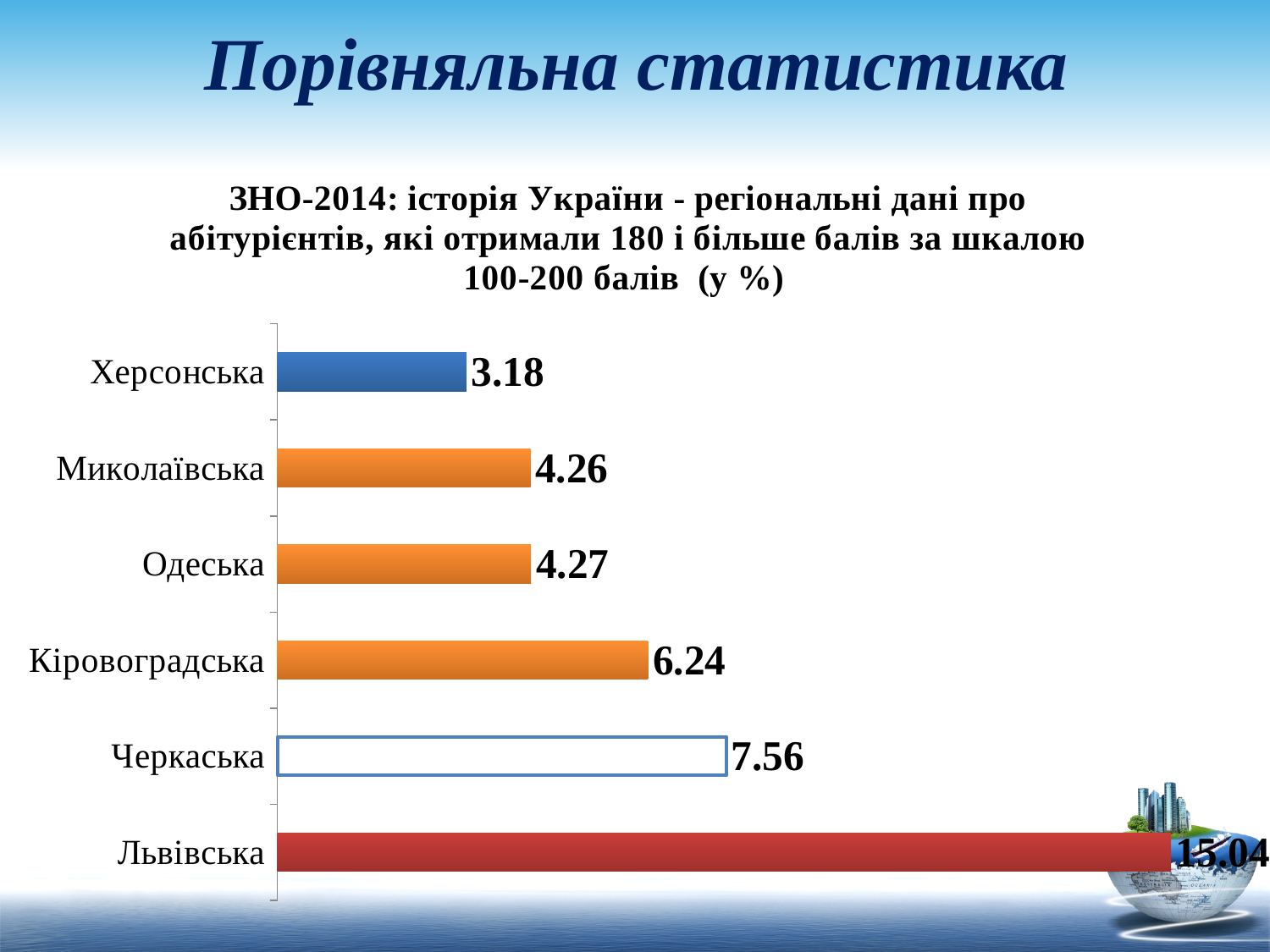
What is the difference between the values for Кіровоградська and Херсонська? 3.06 What colour is the bar for Львівська? Red How many regions are shown in the chart? 6 What is the value for Львівська? 15.04 Which region has the highest value? Львівська What is the difference between the values for Львівська and Черкаська? 7.48 Which is larger, the value for Черкаська or the value for Кіровоградська? Черкаська What is the value for Херсонська? 3.18 Which region has the lowest value? Херсонська What is the value for Кіровоградська? 6.24 What is the value for Черкаська? 7.56 What kind of chart is shown on the slide? Bar chart